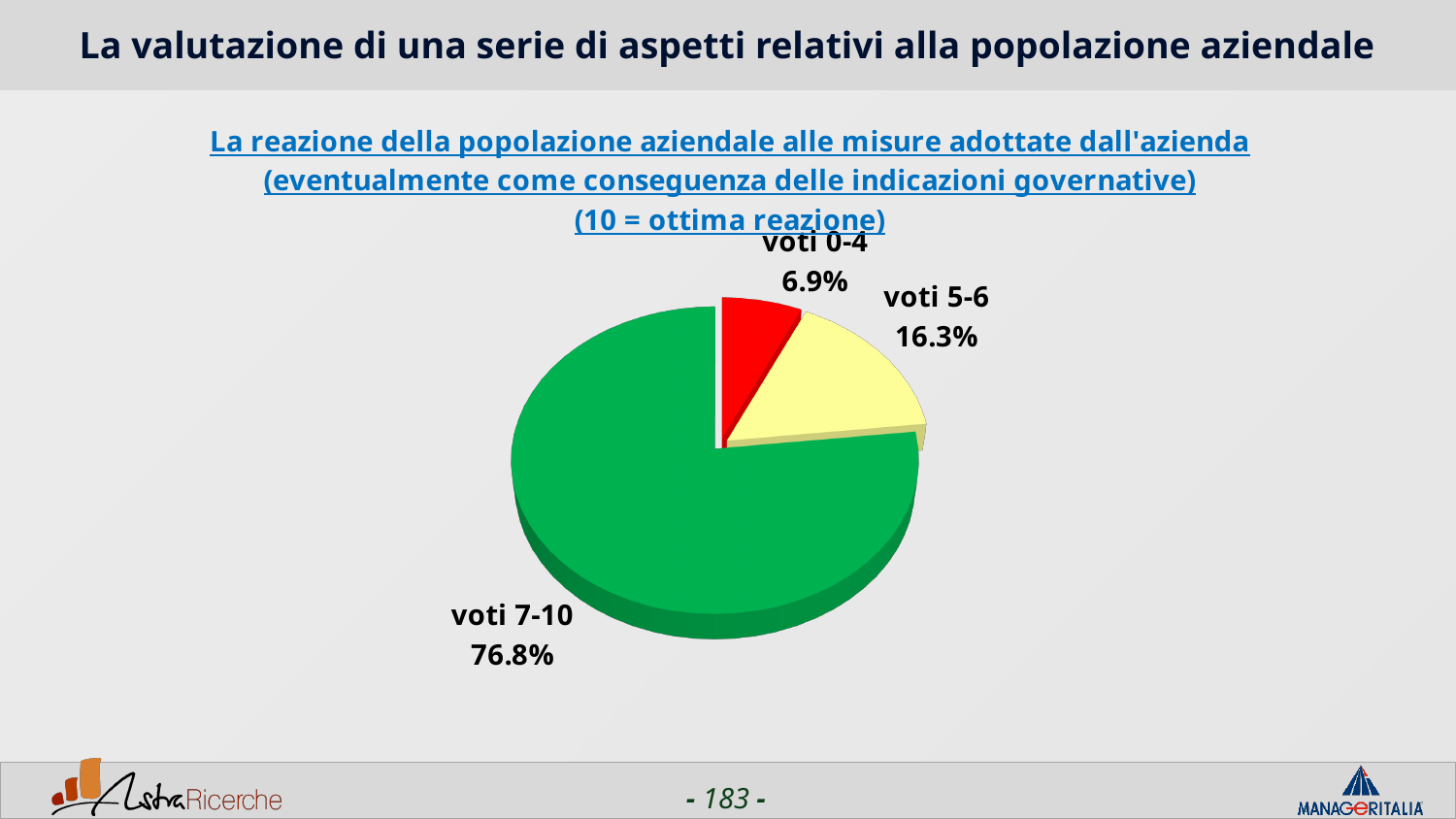
What is the value shown for 'voti 5-6'? 16.3% What colour is the 'voti 7-10' slice? green How many slices does the pie chart have? 3 What is the value shown for 'voti 0-4'? 6.9% What is the difference between the 'voti 5-6' and 'voti 0-4' shares? 9.4% What share of the pie does the 'voti 7-10' slice represent? 76.8% Which category has the smallest slice of the pie? voti 0-4 Which category has the largest slice of the pie? voti 7-10 What kind of chart is shown on the slide? pie chart Which is larger, the 'voti 5-6' slice or the 'voti 0-4' slice? voti 5-6 According to the chart subtitle, what score corresponds to 'ottima reazione'? 10 What is the difference between the 'voti 7-10' and 'voti 5-6' shares? 60.5%